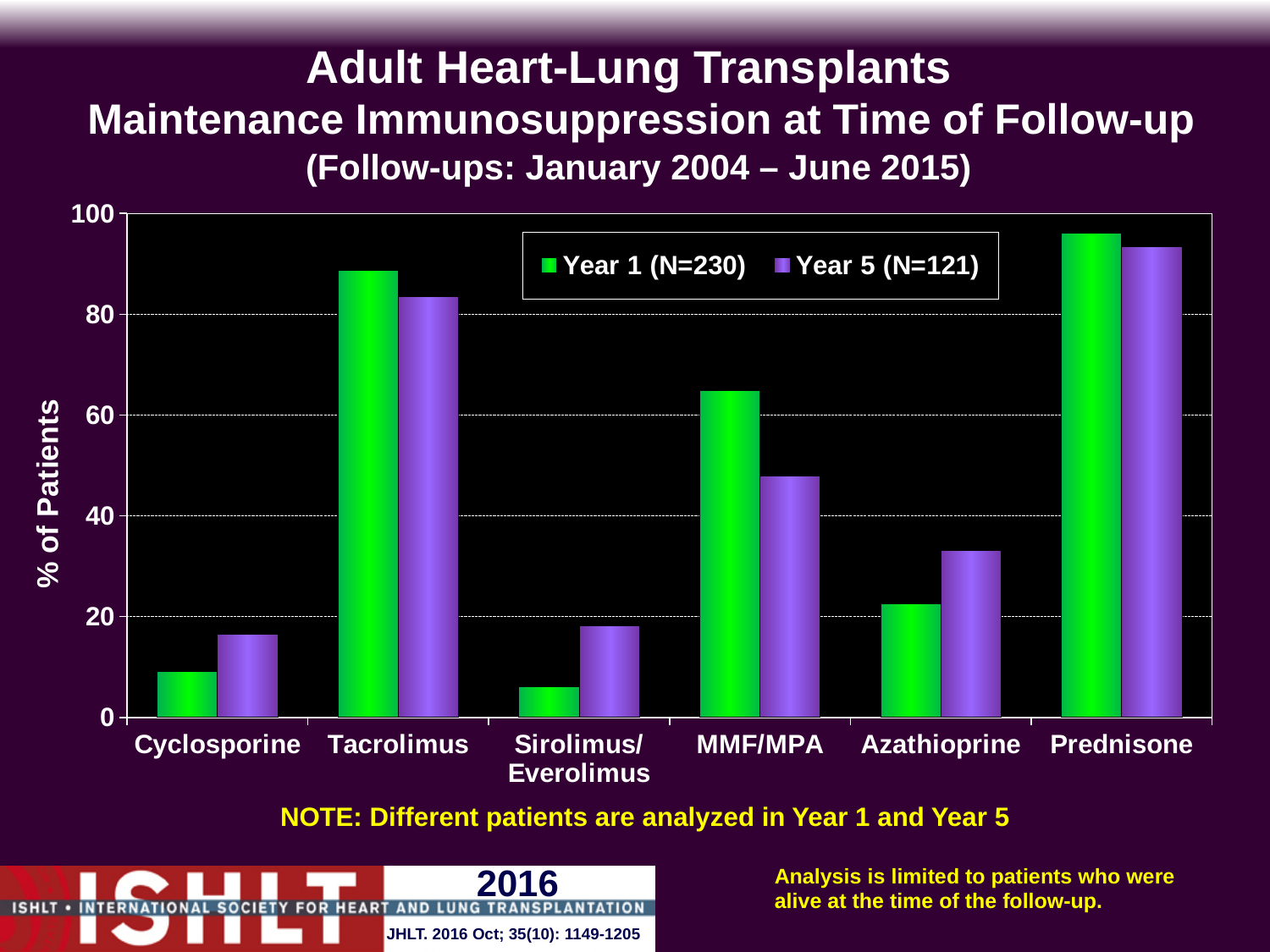
What kind of chart is shown on the slide? Bar chart For Azathioprine, which is larger: the Year 1 (N=230) value or the Year 5 (N=121) value? Year 5 (N=121) Which drug has the lowest Year 1 (N=230) percentage of patients? Sirolimus/Everolimus What is the label on the y axis of the chart? % of Patients Is the Year 5 (N=121) value for Azathioprine greater or less than 20? greater Which drug has the highest Year 1 (N=230) percentage of patients? Prednisone Is the Year 1 (N=230) value for Tacrolimus greater or less than 80? greater How many series does the legend list? 2 Is the Year 1 (N=230) value for Cyclosporine greater or less than 20? less For MMF/MPA, which is larger: the Year 1 (N=230) value or the Year 5 (N=121) value? Year 1 (N=230) How many drug categories are shown on the x axis? 6